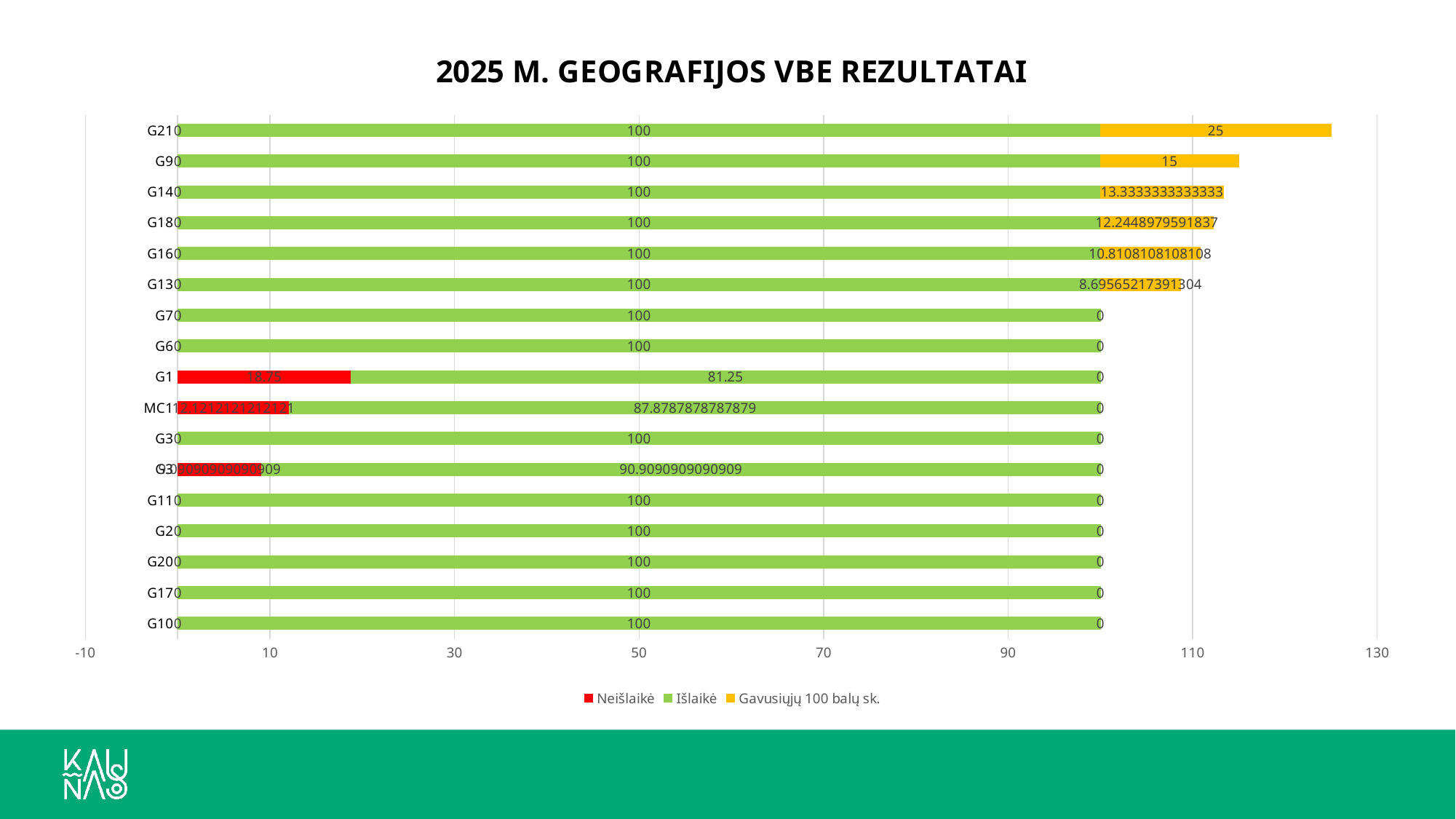
Which category has the highest Gavusiųjų 100 balų sk. value? G210 What kind of chart is shown on the slide? Stacked bar chart What is the Gavusiųjų 100 balų sk. value for G90? 15 How many series does the legend list? 3 What is the total of the stacked bar for G210? 125 What is the difference between the Gavusiųjų 100 balų sk. values for G210 and G90? 10 What is the Išlaikė value for MC1? 87.8787878787879 What is the Neišlaikė value for G1? 18.75 Which has a larger Neišlaikė value, G1 or MC1? G1 Which category has the lowest Išlaikė value? G1 How many categories are shown on the chart? 17 What is the Gavusiųjų 100 balų sk. value for G210? 25